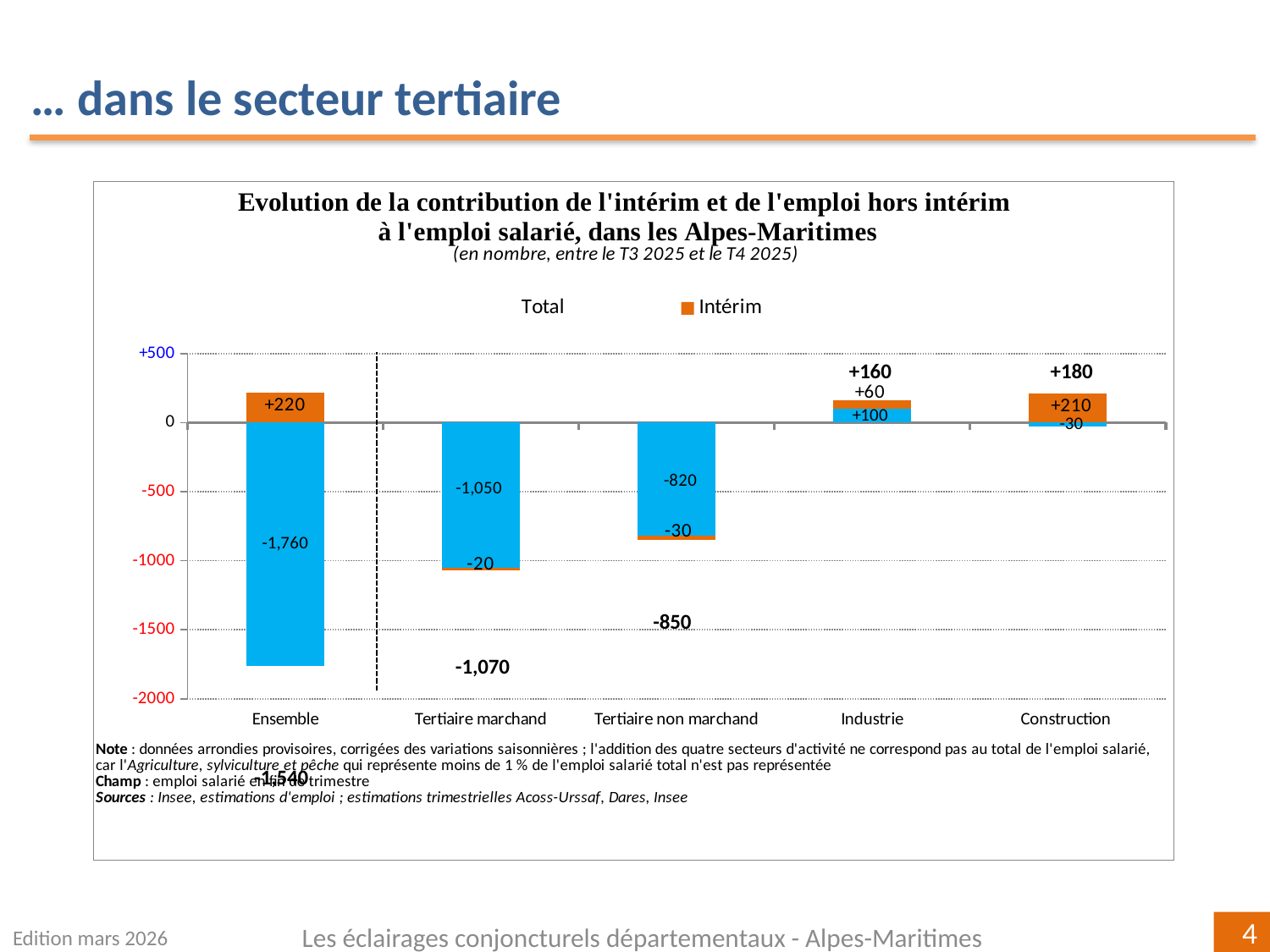
How many categories are shown on the x axis? 5 What is the total value shown for Tertiaire marchand? -1,070 What is the Intérim value for Construction? +210 How many series does the legend list? 2 What is the difference between the total for Construction and the total for Industrie? 20 Which has the lower blue bar value, Tertiaire marchand or Tertiaire non marchand? Tertiaire marchand What is the value of the blue bar for Tertiaire non marchand? -820 What kind of chart is shown on the slide? Bar chart What is the Intérim value for Industrie? +60 Which category has the highest total value? Construction Which category has the lowest total value? Ensemble What is the Intérim value for Ensemble? +220